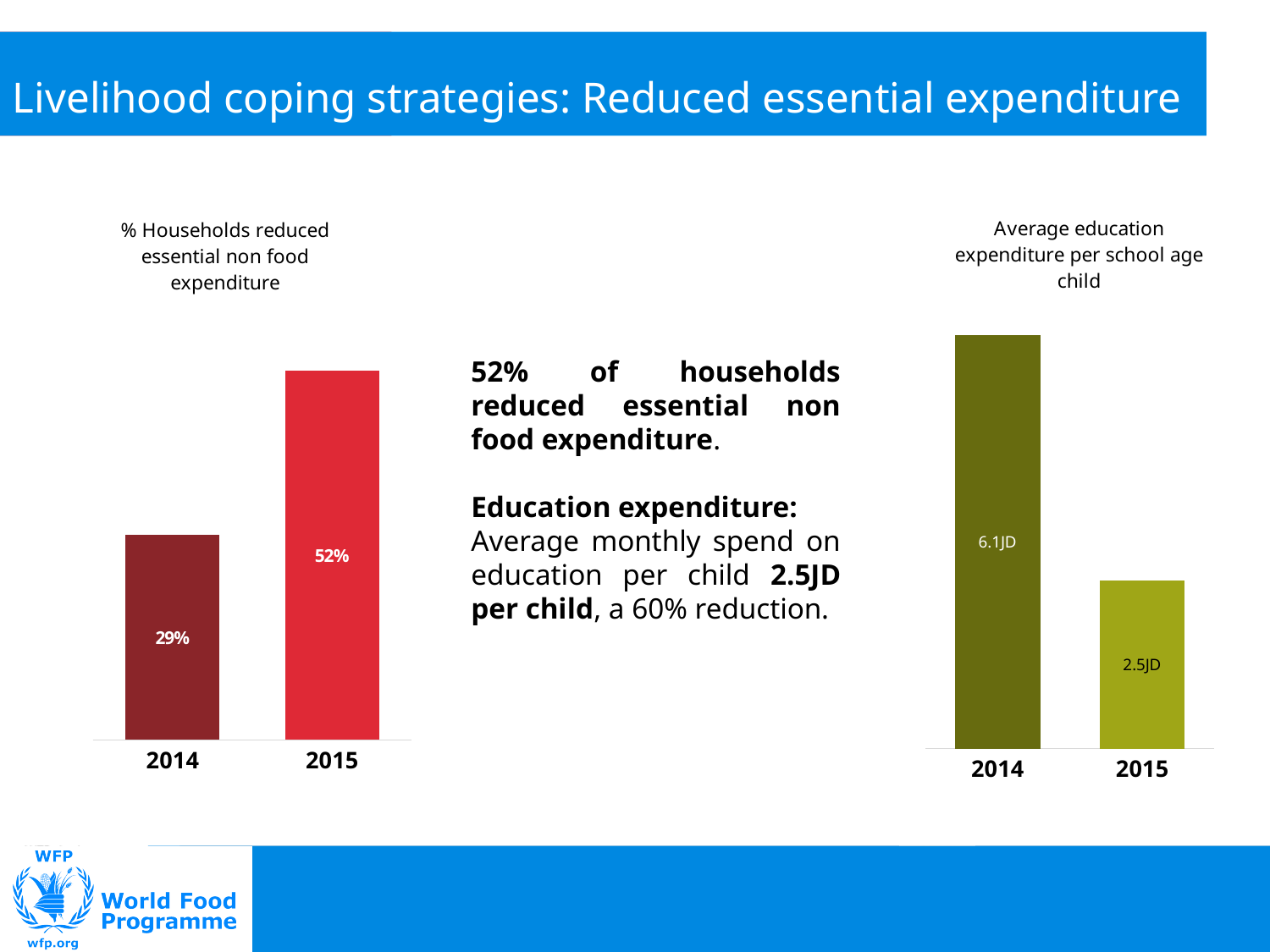
In the '% Households reduced essential non food expenditure' chart, which year has the higher value? 2015 In the 'Average education expenditure per school age child' chart, is the value for 2014 larger or smaller than the value for 2015? larger In the '% Households reduced essential non food expenditure' chart, what is the value for 2014? 29% In the '% Households reduced essential non food expenditure' chart, what is the value for 2015? 52% In the 'Average education expenditure per school age child' chart, what is the value for 2014? 6.1JD In the 'Average education expenditure per school age child' chart, what is the difference between the 2014 and 2015 values? 3.6JD In the 'Average education expenditure per school age child' chart, what is the value for 2015? 2.5JD In the 'Average education expenditure per school age child' chart, which year has the lower value? 2015 In the 'Average education expenditure per school age child' chart, do the values rise or fall from 2014 to 2015? fall In the '% Households reduced essential non food expenditure' chart, what is the difference between the 2015 and 2014 values? 23% What kind of chart is the 'Average education expenditure per school age child' chart? bar chart How many bars are in the '% Households reduced essential non food expenditure' chart? 2